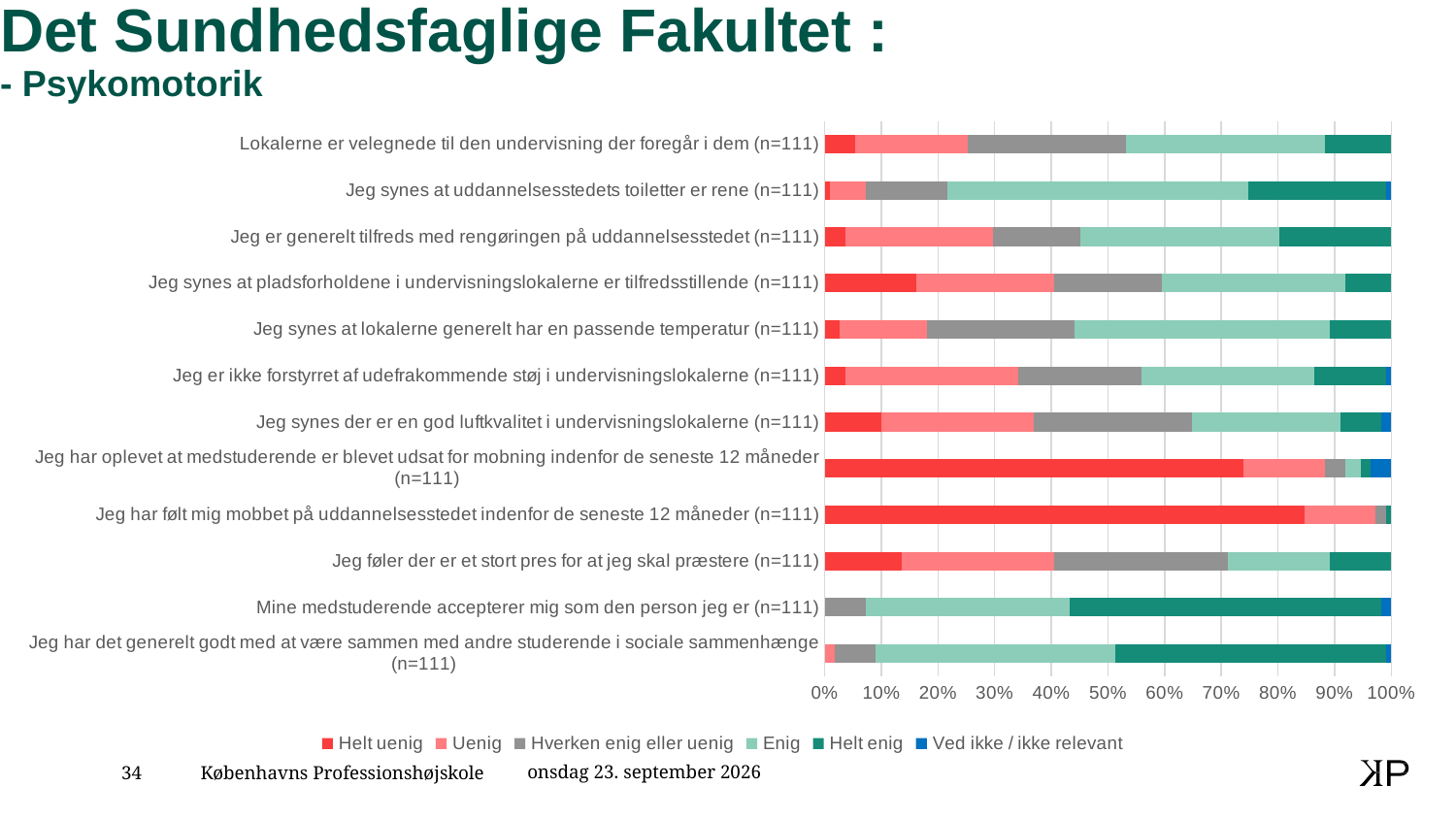
Is the 'Helt uenig' share for 'Jeg synes at pladsforholdene i undervisningslokalerne er tilfredsstillende' greater or less than 10%? greater How many series does the legend list? 6 Is the 'Helt uenig' share for 'Jeg har følt mig mobbet på uddannelsesstedet indenfor de seneste 12 måneder' greater or less than 80%? greater Which has the larger 'Helt uenig' segment: 'Jeg synes der er en god luftkvalitet i undervisningslokalerne' or 'Jeg synes at uddannelsesstedets toiletter er rene'? Jeg synes der er en god luftkvalitet i undervisningslokalerne What kind of chart is shown on the slide? Stacked bar chart How many statements (categories) are plotted on the chart? 12 Is the 'Helt enig' share for 'Mine medstuderende accepterer mig som den person jeg er' greater or less than 50%? greater Which response category is shown in dark green in the legend? Helt enig Which statement has the largest 'Helt uenig' segment? Jeg har følt mig mobbet på uddannelsesstedet indenfor de seneste 12 måneder (n=111) What is the sample size (n) shown for each statement? 111